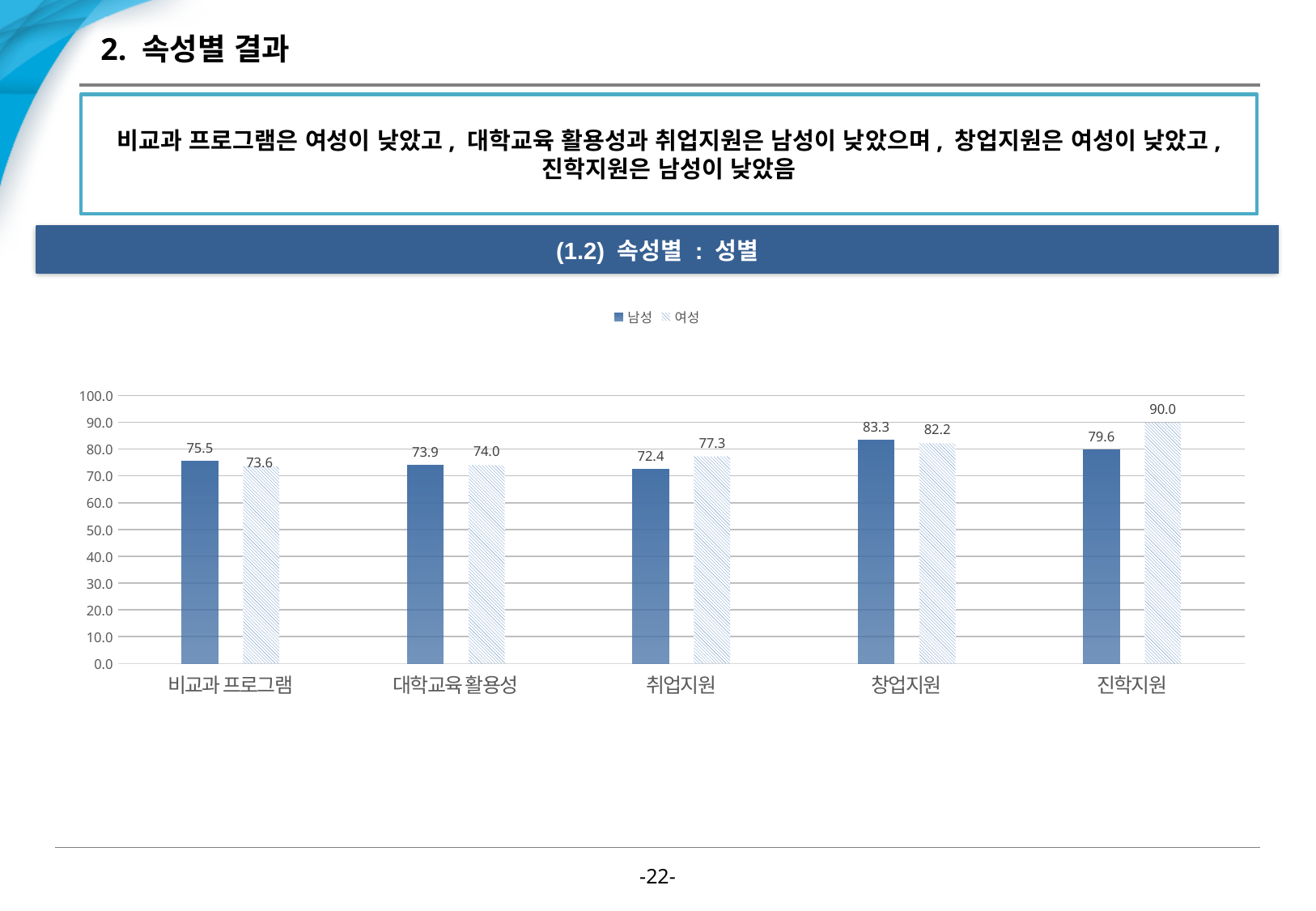
How many categories are shown on the x axis? 5 Which category has the lowest value for 남성? 취업지원 What is the value for 여성 in the 취업지원 category? 77.3 What is the difference between the 여성 and 남성 values in the 진학지원 category? 10.4 What is the value for 여성 in the 진학지원 category? 90.0 Which category has the lowest value for 여성? 비교과 프로그램 In the 취업지원 category, which is larger, the 남성 value or the 여성 value? 여성 What kind of chart is shown on the slide? bar chart What is the value for 남성 in the 비교과 프로그램 category? 75.5 Is the 남성 value for 창업지원 greater or less than 80.0? greater How many series does the legend list? 2 Which category has the highest value for 남성? 창업지원